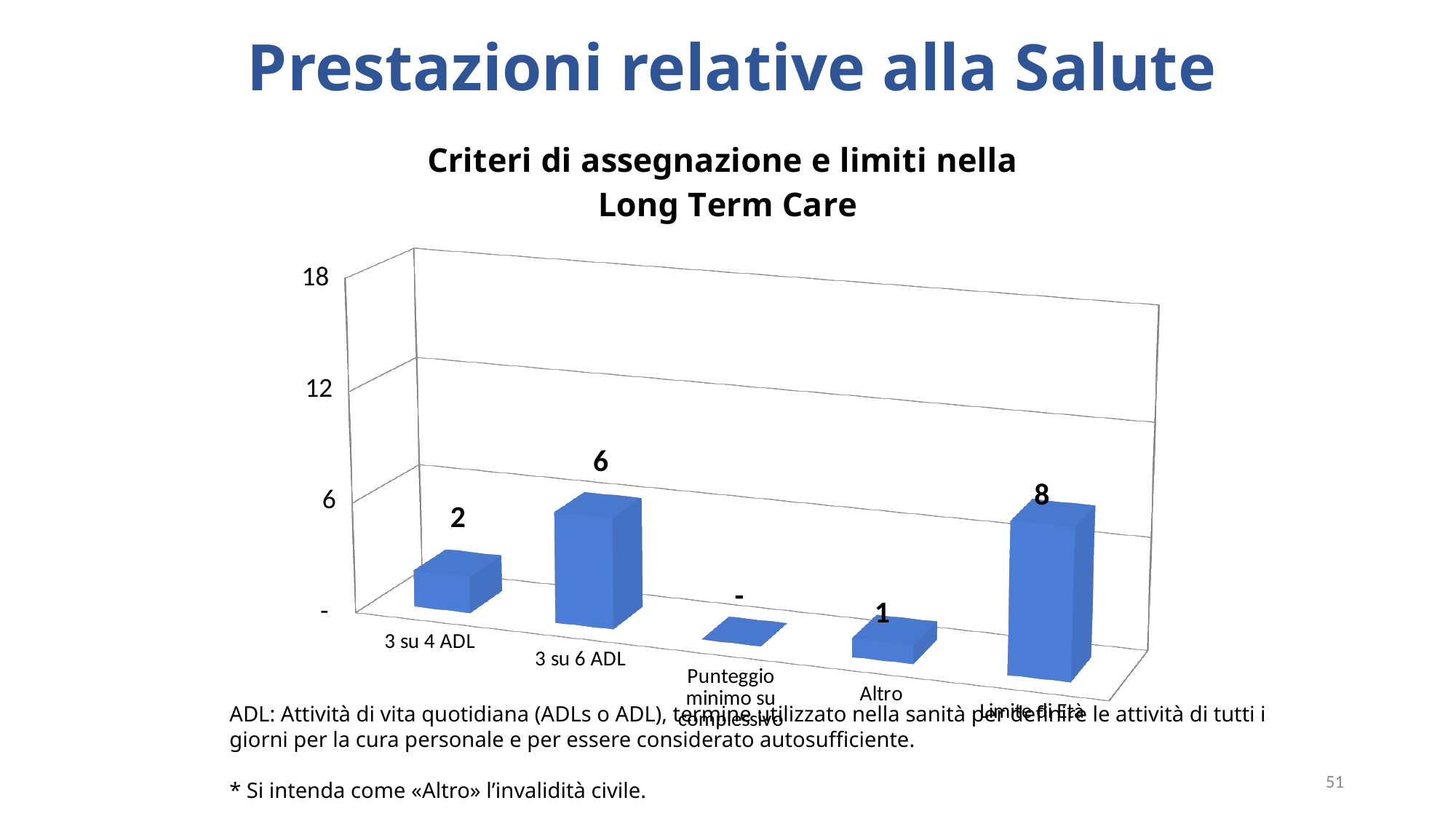
What is the value for 'Altro'? 1 What is the value for 'Limite di Età'? 8 What is the value for '3 su 6 ADL'? 6 Which category has the highest value? Limite di Età What is the difference between the values for 'Limite di Età' and '3 su 6 ADL'? 2 How many categories are shown on the x axis? 5 What data label is shown for 'Punteggio minimo su complessivo'? - Which is larger, the value for '3 su 4 ADL' or the value for 'Altro'? 3 su 4 ADL Which category has the lowest value? Punteggio minimo su complessivo What type of chart is shown on the slide? Bar chart What is the value for '3 su 4 ADL'? 2 Is the value for 'Limite di Età' greater or less than 12? less